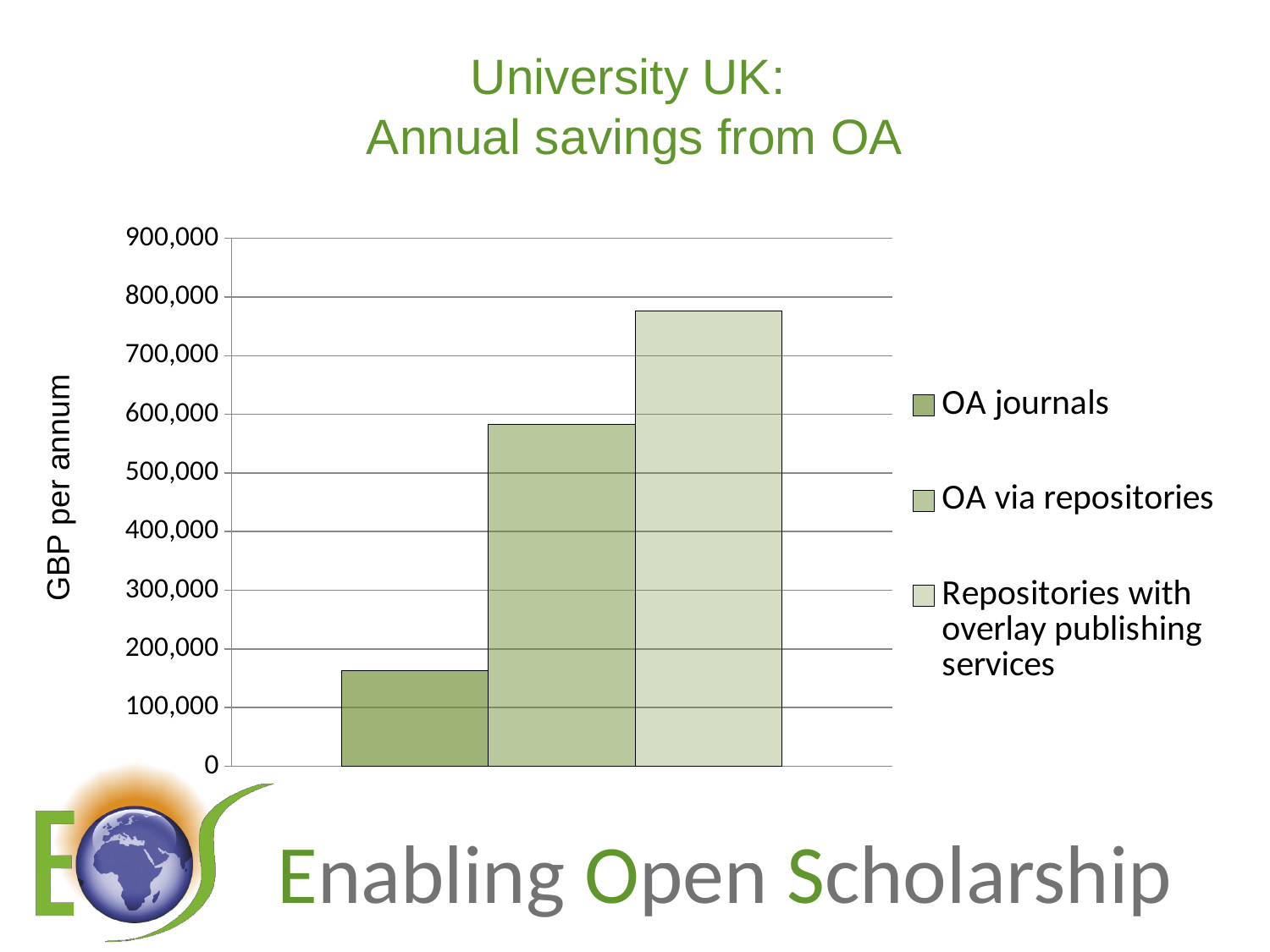
Is the value for Repositories with overlay publishing services greater or less than 700,000? greater How many entries does the legend list? 3 Is the value for OA journals greater or less than 200,000? less Which is larger, the value for OA journals or the value for OA via repositories? OA via repositories What is the label on the vertical axis of the chart? GBP per annum What kind of chart is shown on the slide? bar chart How many bars are plotted in the chart? 3 Is the value for OA via repositories greater or less than 500,000? greater Which series has the highest annual savings? Repositories with overlay publishing services What is the title of the chart? University UK: Annual savings from OA Which series has the lowest annual savings? OA journals